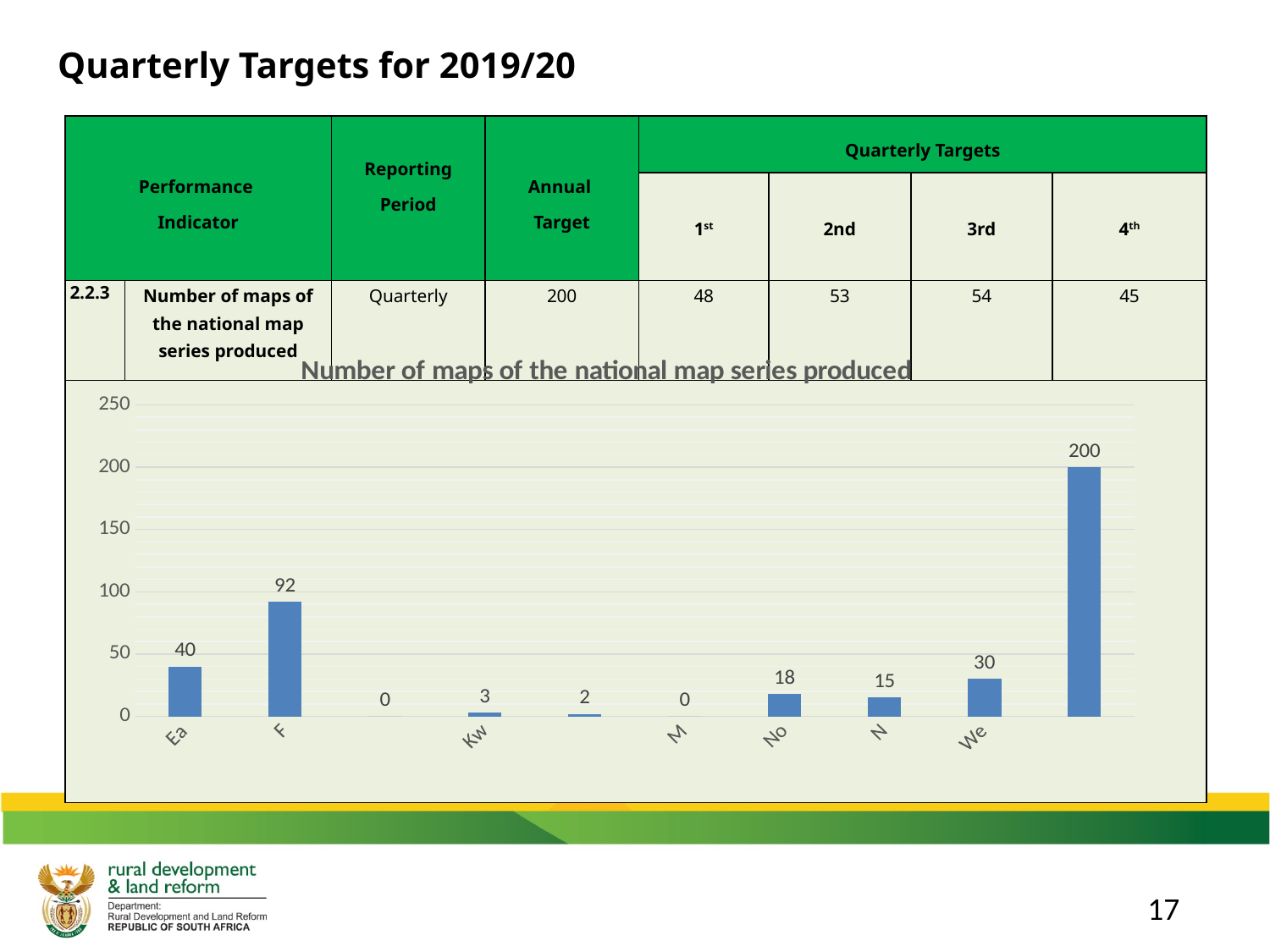
What is the highest value shown on the vertical axis of the chart? 250 How many bars are plotted in the chart? 10 What is the value of the bar labelled "Ea"? 40 Which bar has the highest value in the chart? the rightmost bar (200) What is the value of the bar labelled "F"? 92 What is the value of the last (rightmost) bar in the chart? 200 What is the difference between the bar labelled "F" and the bar labelled "Ea"? 52 What is the value of the bar labelled "We"? 30 Which is larger, the bar labelled "No" or the bar labelled "N"? No Is the value for the bar labelled "F" greater or less than 100? less What kind of chart is shown on the slide? bar chart What is the title of the chart? Number of maps of the national map series produced